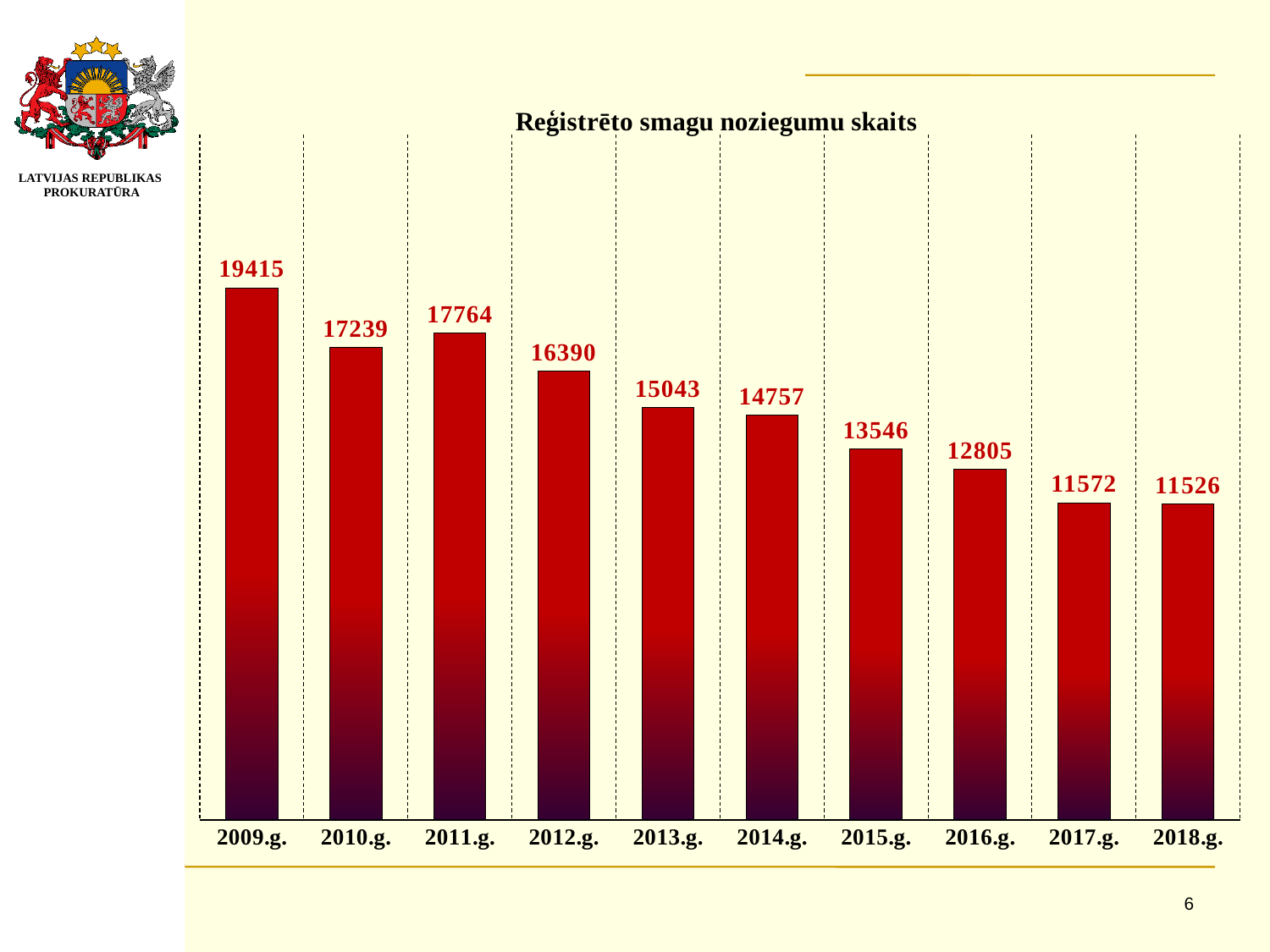
Which is larger, the value for 2010.g. or the value for 2011.g.? 2011.g. Which year has the highest value? 2009.g. How many years are shown on the x axis? 10 What is the value for 2014.g.? 14757 What is the title of the chart? Reģistrēto smagu noziegumu skaits What is the value for 2009.g.? 19415 What kind of chart is this? bar chart What is the value for 2018.g.? 11526 Which year has the lowest value? 2018.g. Do the values generally rise or fall from 2009.g. to 2018.g.? fall What is the difference between the values for 2010.g. and 2011.g.? 525 What is the difference between the values for 2009.g. and 2018.g.? 7889